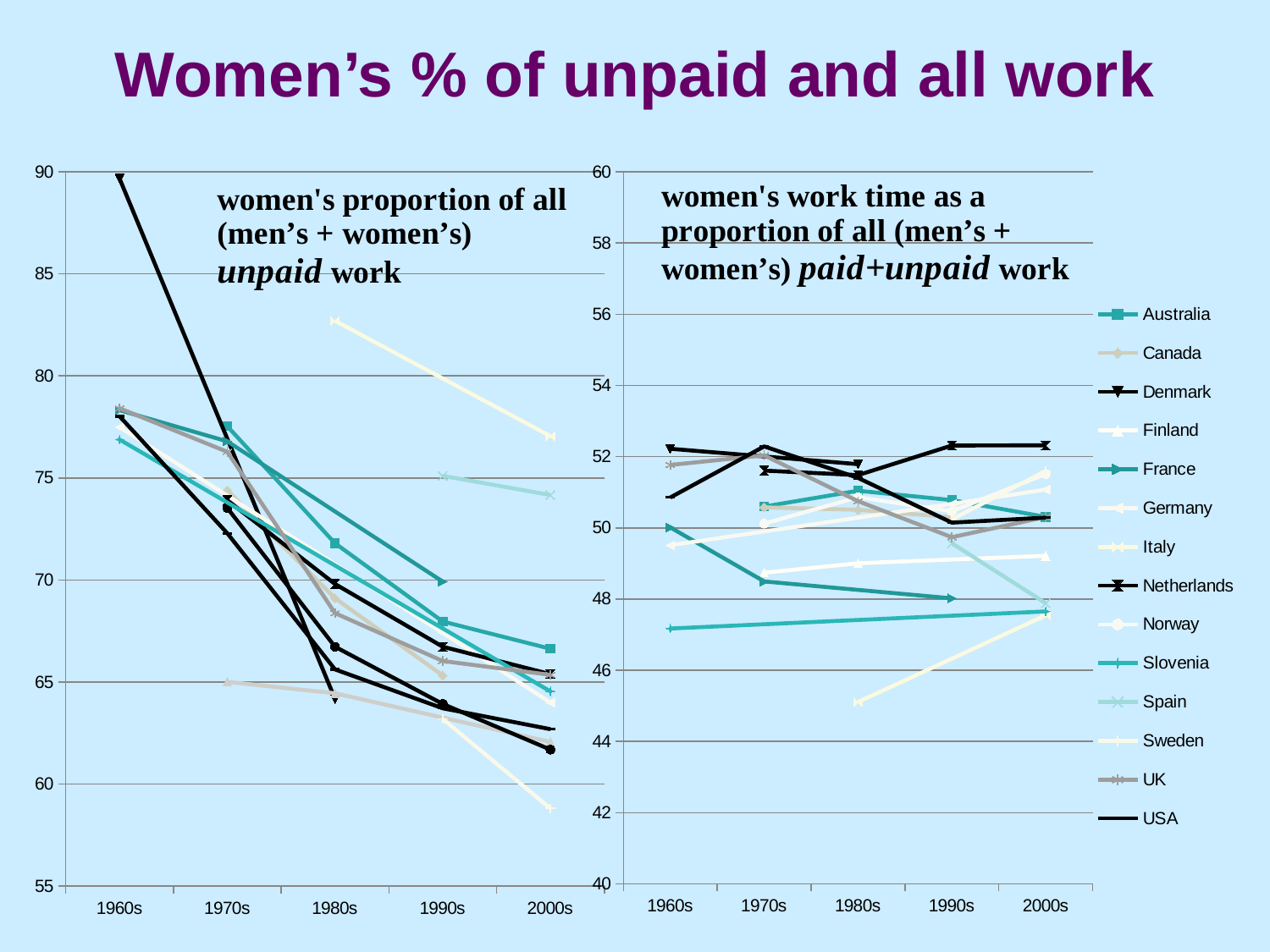
What is the title of the slide? Women's % of unpaid and all work In the left chart on unpaid work, how many decades are shown along the x axis? 5 In the right chart on paid+unpaid work, is the value for Slovenia in the 1960s greater or less than 48? less In the right chart on paid+unpaid work, is the value for Italy in the 1980s greater or less than 46? less In the right chart on paid+unpaid work, does the Slovenia line rise or fall from the 1960s to the 2000s? rise In the left chart on unpaid work, is the value for Italy in the 2000s greater or less than 75? greater How many series does the legend list? 14 In the left chart on unpaid work, does the USA line rise or fall from the 1960s to the 2000s? fall What kind of chart is the left chart, 'women's proportion of all (men's + women's) unpaid work'? line chart What kind of chart is the right chart, 'women's work time as a proportion of all (men's + women's) paid+unpaid work'? line chart